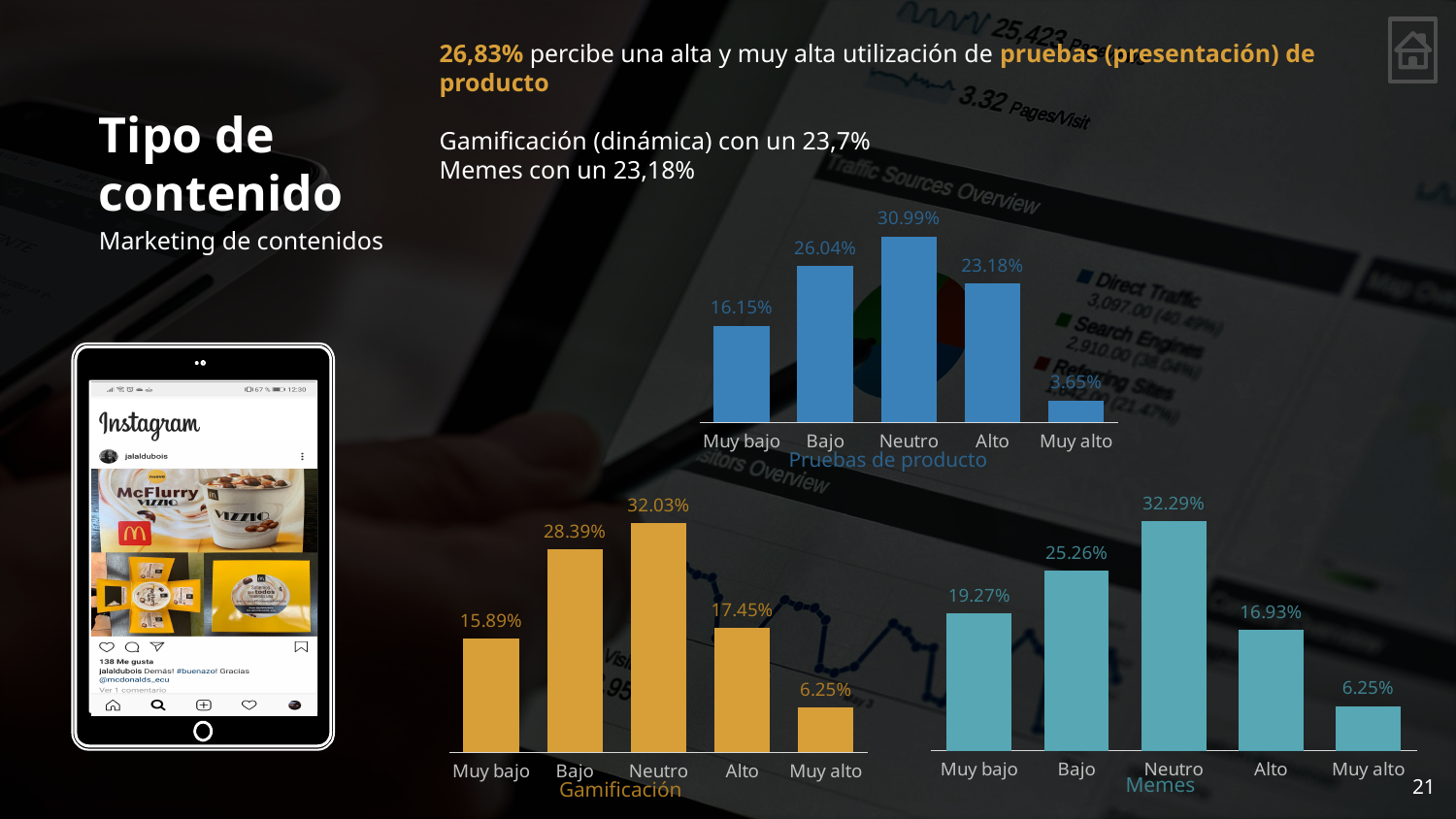
In the Memes chart, which is larger, Alto or Muy alto? Alto How many categories does the Memes chart show? 5 What type of chart is the Gamificación chart? Bar chart In the Pruebas de producto chart, what is the value for Neutro? 30.99% In the Memes chart, what is the difference between Neutro and Bajo? 7.03% In the Pruebas de producto chart, what is the difference between Bajo and Alto? 2.86% In the Pruebas de producto chart, which category has the lowest value? Muy alto What is the title of the blue chart at the top of the slide? Pruebas de producto In the Gamificación chart, what is the value for Bajo? 28.39% In the Memes chart, what is the value for Muy bajo? 19.27% In the Gamificación chart, which is larger, Muy bajo or Alto? Alto In the Gamificación chart, which category has the highest value? Neutro